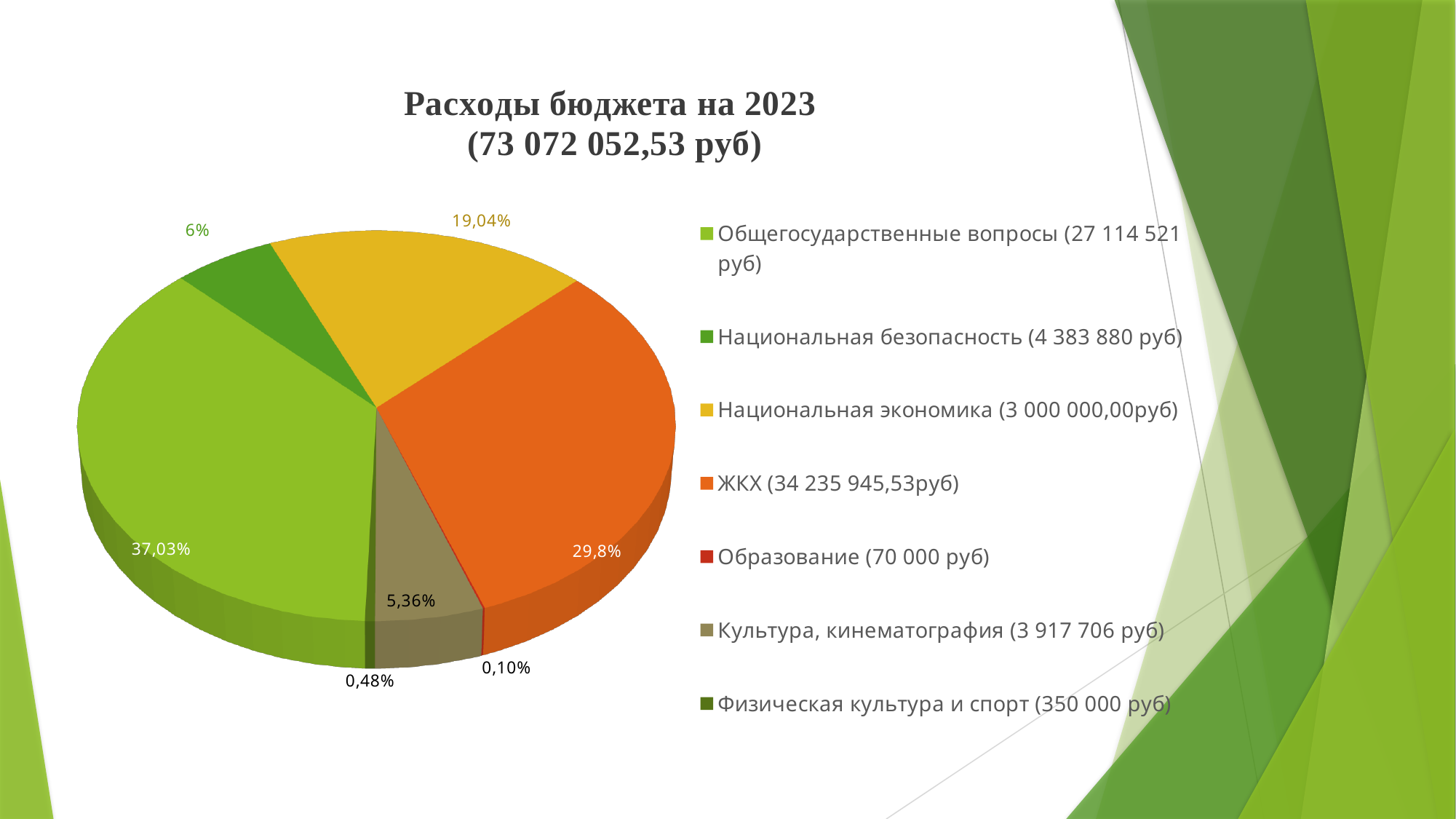
What is the difference in percentage points between the ЖКХ slice and the Национальная экономика slice? 10,76 How many slices does the pie chart have? 7 What is the title of the chart? Расходы бюджета на 2023 (73 072 052,53 руб) What kind of chart is shown on the slide? pie chart What share of the pie is labelled for Национальная экономика? 19,04% What share of the pie is labelled for Общегосударственные вопросы? 37,03% Which category has the largest slice of the pie? Общегосударственные вопросы Which category has the smallest slice of the pie? Образование What share of the pie is labelled for Образование? 0,10% Which slice is larger: Национальная безопасность or Национальная экономика? Национальная экономика